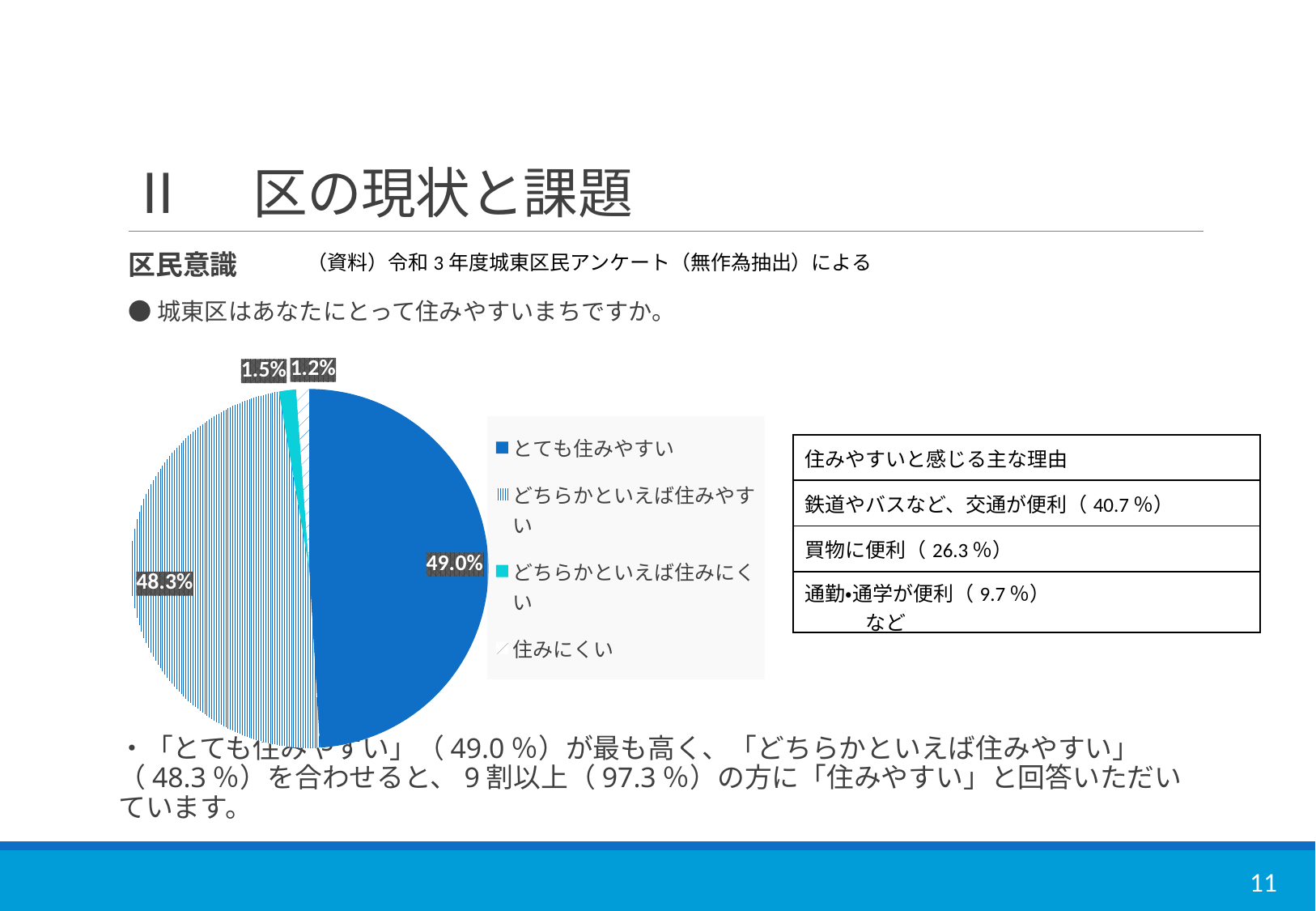
What is the combined share of 「とても住みやすい」 and 「どちらかといえば住みやすい」 in the pie chart? 97.3% What is the difference in percentage points between 「とても住みやすい」 and 「どちらかといえば住みやすい」? 0.7 Which category has the largest share of the pie chart? とても住みやすい Which category has the smallest share of the pie chart? 住みにくい How many categories does the pie chart show? 4 What percentage of the pie chart is 「とても住みやすい」? 49.0% What type of chart is shown on the slide? Pie chart What percentage of the pie chart is 「住みにくい」? 1.2% Which is larger in the pie chart, 「どちらかといえば住みにくい」 or 「住みにくい」? どちらかといえば住みにくい What percentage of the pie chart is 「どちらかといえば住みにくい」? 1.5% What percentage of the pie chart is 「どちらかといえば住みやすい」? 48.3% How many entries does the legend of the pie chart list? 4